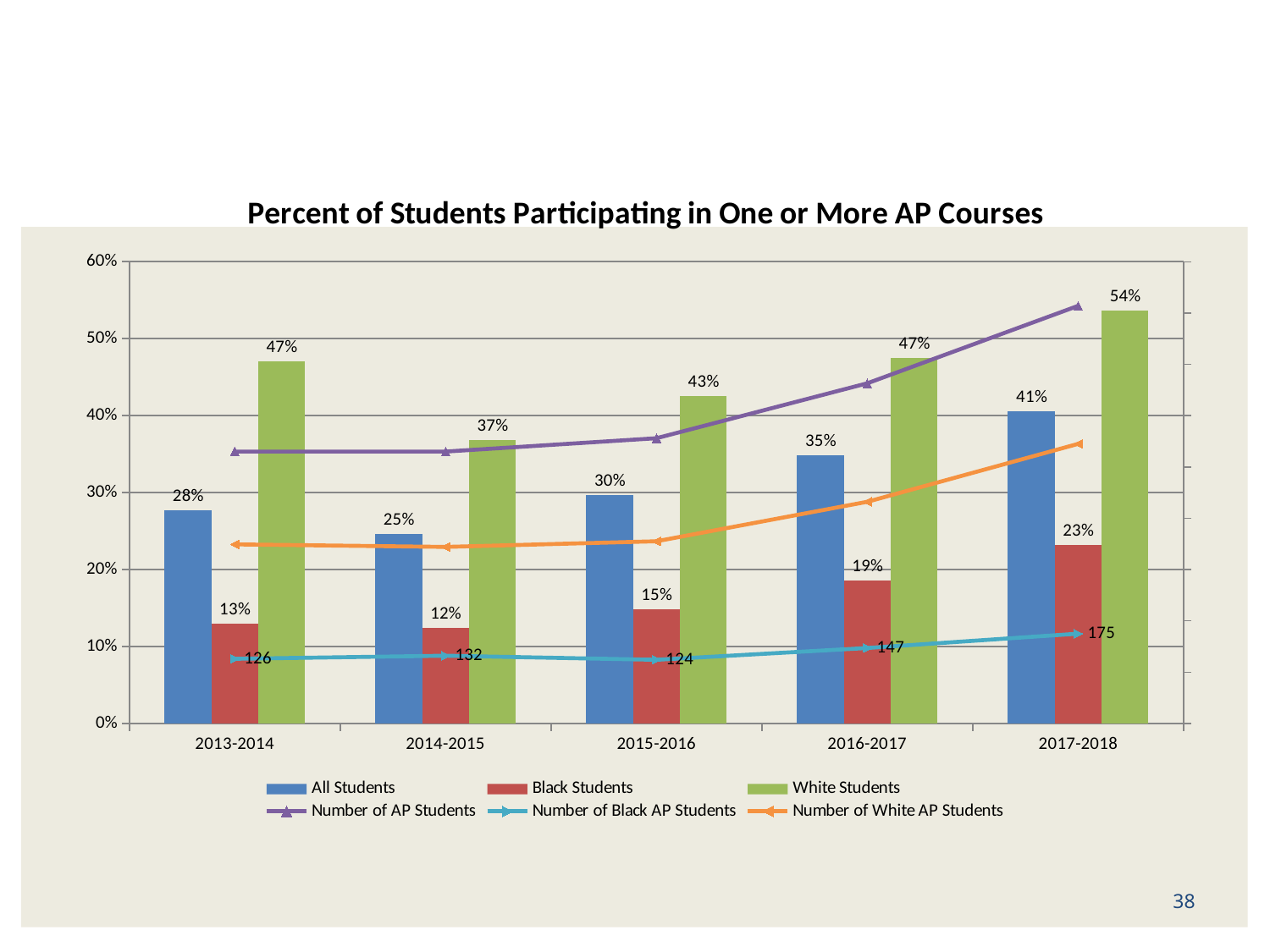
What is the value for White Students in 2017-2018? 54% Does the value for Black Students rise or fall from 2014-2015 to 2017-2018? Rise How many school years are shown on the x axis? 5 How many series does the legend list? 6 What is the difference between the White Students and Black Students values in 2013-2014? 34% Which is larger in 2015-2016: the value for All Students or the value for Black Students? All Students What kind of chart is this? Combined bar and line chart In which school year is the value for White Students lowest? 2014-2015 What is the Number of Black AP Students in 2016-2017? 147 What is the title of the chart? Percent of Students Participating in One or More AP Courses In which school year is the value for All Students highest? 2017-2018 What is the value for Black Students in 2014-2015? 12%